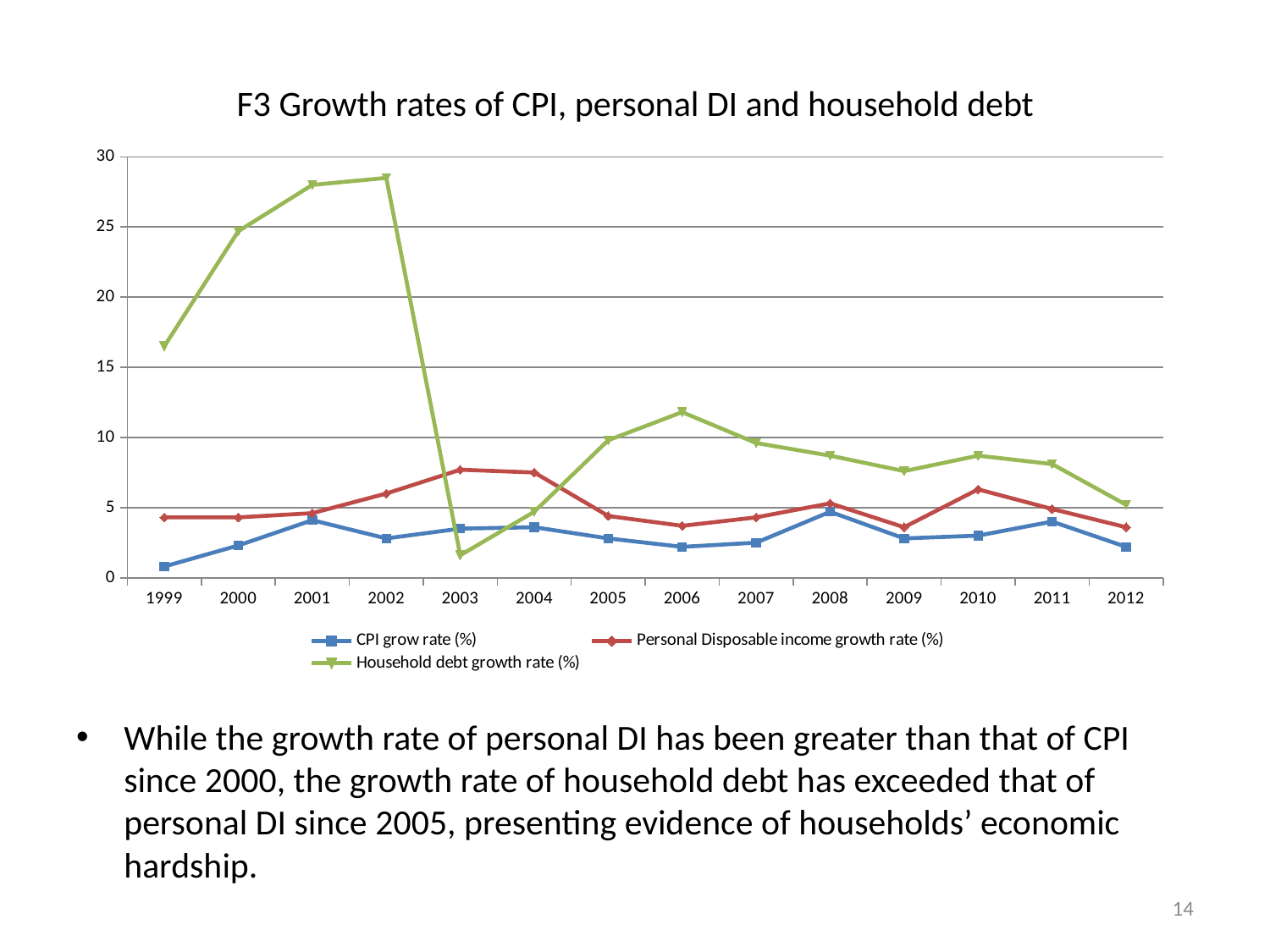
What kind of chart is shown on the slide? line chart Is the Household debt growth rate (%) in 2002 greater or less than 25? greater How many years are shown on the x axis? 14 What is the title of the chart? F3 Growth rates of CPI, personal DI and household debt Which series is drawn in green? Household debt growth rate (%) In 2006, which is larger: the Household debt growth rate (%) or the Personal Disposable income growth rate (%)? Household debt growth rate (%) How many series does the legend list? 3 In which year is the CPI grow rate (%) highest? 2008 In which year is the CPI grow rate (%) lowest? 1999 Does the Household debt growth rate (%) rise or fall from 2002 to 2003? fall In which year is the Household debt growth rate (%) lowest? 2003 Is the Household debt growth rate (%) in 2003 greater or less than 5? less